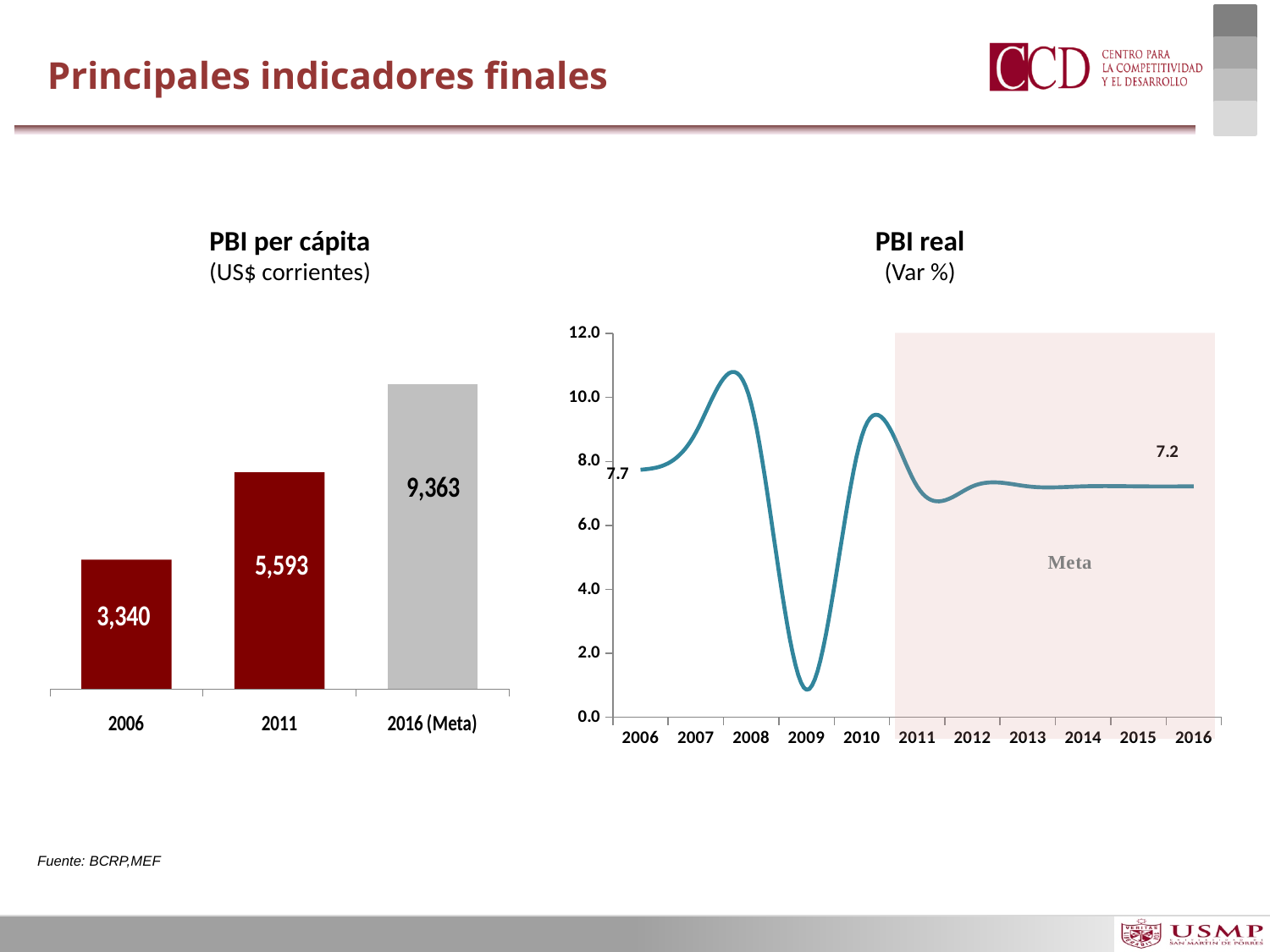
In the PBI real chart, what is the value labelled for 2006? 7.7 In the PBI per cápita chart, what is the value for 2006? 3,340 In the PBI per cápita chart, what is the value for 2011? 5,593 In the PBI per cápita chart, what is the value for 2016 (Meta)? 9,363 What kind of chart is the PBI per cápita chart? Bar chart In the PBI per cápita chart, which category has the lowest value? 2006 In the PBI per cápita chart, which category has the highest value? 2016 (Meta) What kind of chart is the PBI real chart? Line chart In the PBI real chart, what is the value labelled for 2016? 7.2 In the PBI per cápita chart, what is the difference between the 2011 value and the 2006 value? 2,253 In the PBI per cápita chart, how many bars are shown? 3 In the PBI real chart, is the value for 2009 greater or less than 2.0? less